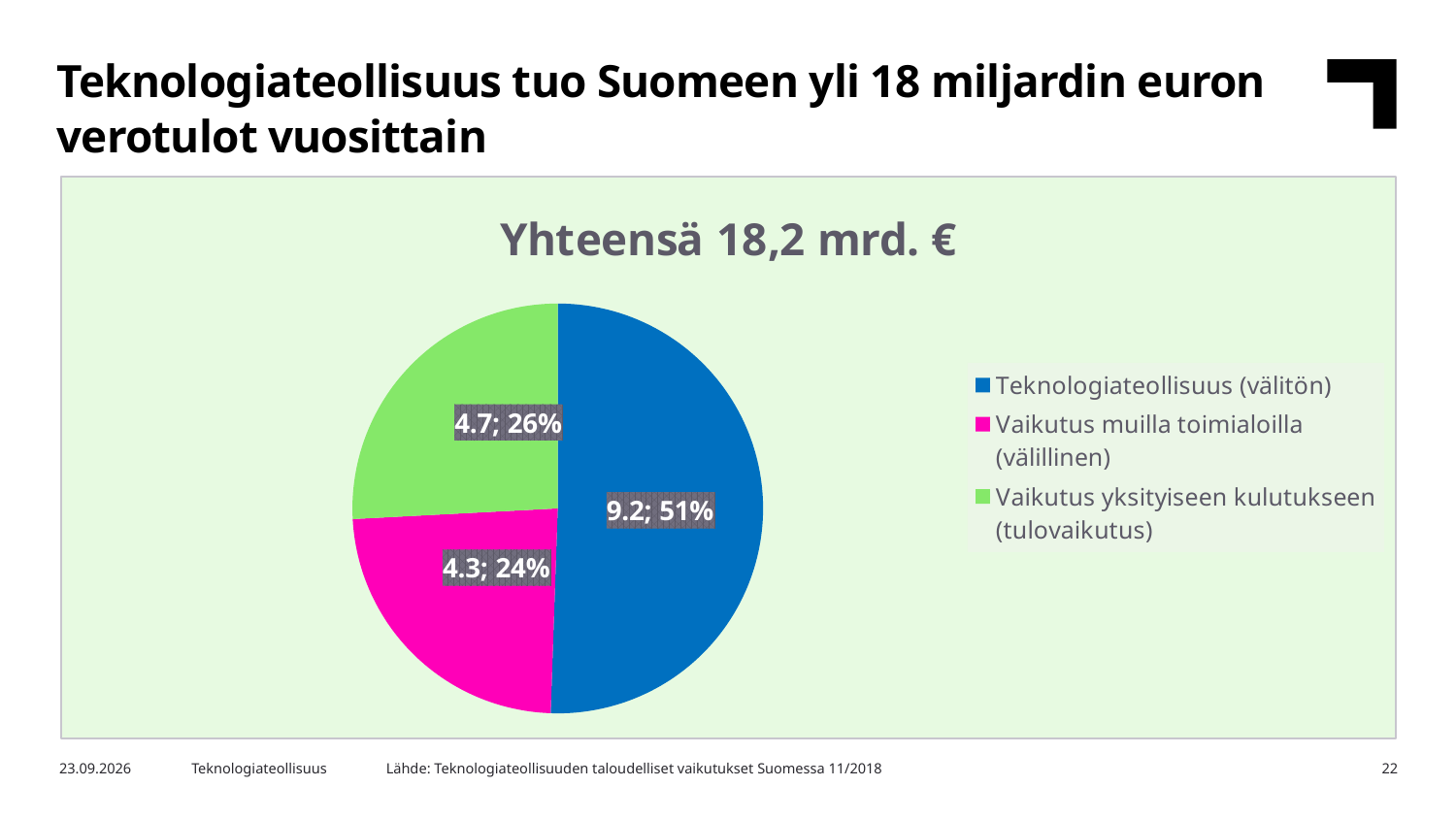
What kind of chart is shown on the slide? pie chart What is the difference between the values for Teknologiateollisuus (välitön) and Vaikutus muilla toimialoilla (välillinen)? 4.9 What is the chart's title? Yhteensä 18,2 mrd. € What share of the pie does Teknologiateollisuus (välitön) represent? 51% What value is shown for Vaikutus yksityiseen kulutukseen (tulovaikutus)? 4.7 Which slice is the largest? Teknologiateollisuus (välitön) How many slices does the pie chart have? 3 What share of the pie does Vaikutus yksityiseen kulutukseen (tulovaikutus) represent? 26% What value is shown for Teknologiateollisuus (välitön)? 9.2 Which slice is the smallest? Vaikutus muilla toimialoilla (välillinen) How many entries does the legend list? 3 What value is shown for Vaikutus muilla toimialoilla (välillinen)? 4.3